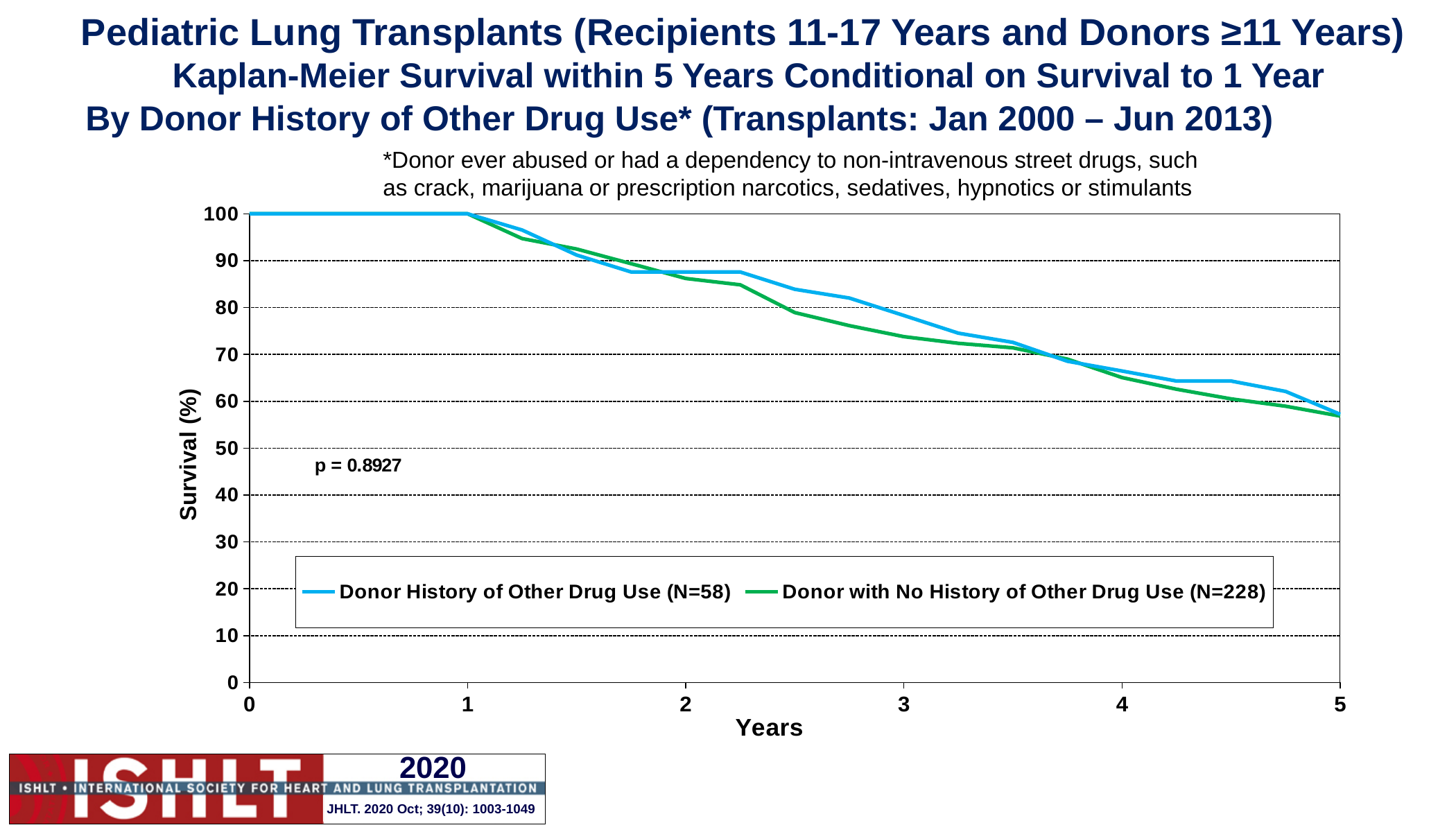
How many series does the legend list? 2 Is the survival for Donor with No History of Other Drug Use at 3 years greater or less than 80? less Do the survival curves rise or fall as years increase? fall What is the survival (%) for Donor with No History of Other Drug Use at 1 year? 100 What is the sample size (N) for the Donor with No History of Other Drug Use series? 228 Is the survival for Donor with No History of Other Drug Use at 5 years greater or less than 60? less Is the survival for Donor History of Other Drug Use at 3 years greater or less than 70? greater At 3 years, which series has the higher survival: Donor History of Other Drug Use or Donor with No History of Other Drug Use? Donor History of Other Drug Use What is the survival (%) for Donor History of Other Drug Use at 1 year? 100 What kind of chart is shown on the slide? line chart What p-value is printed on the chart? p = 0.8927